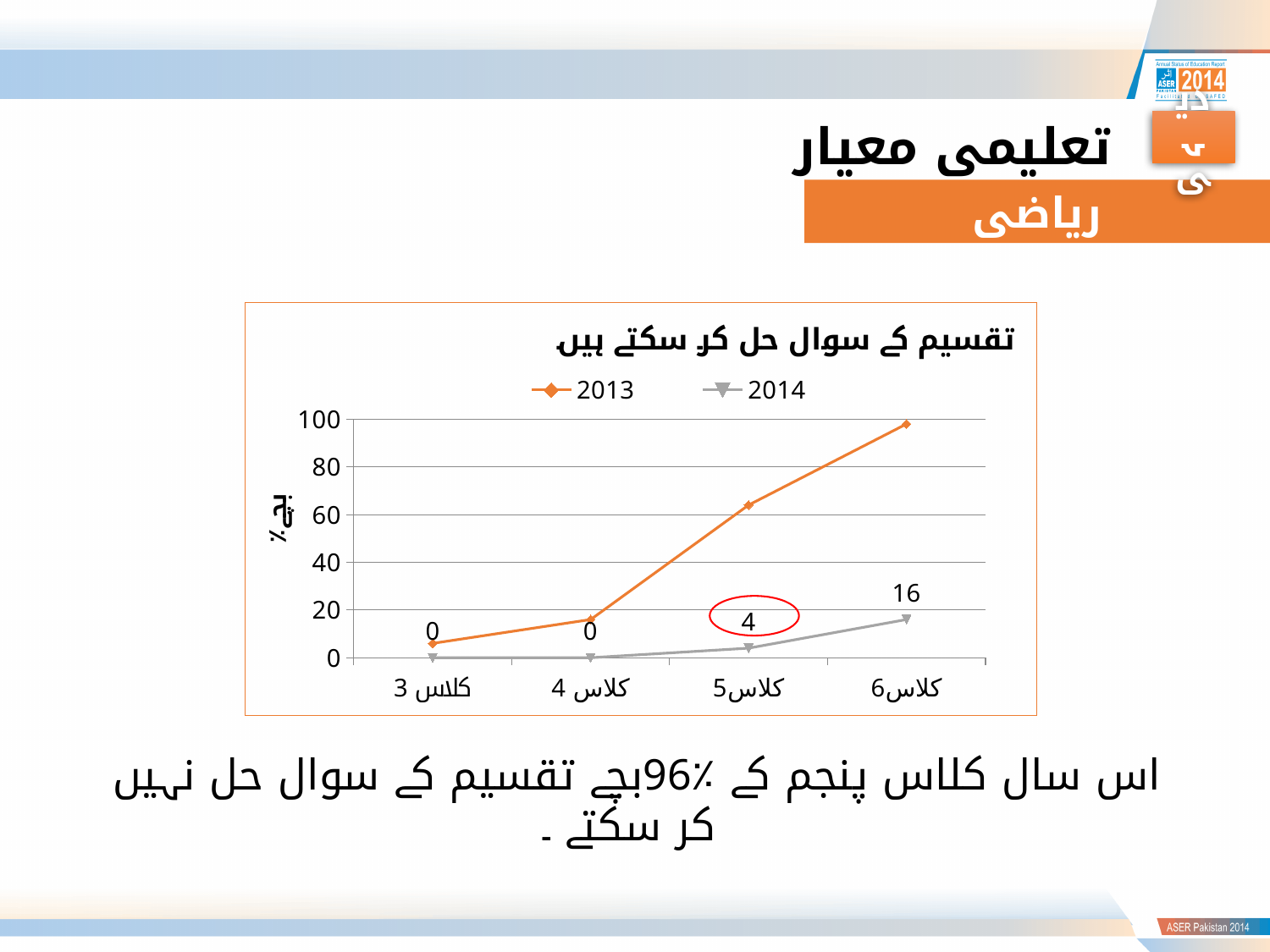
Which category has the highest 2014 value? کلاس 6 What is the 2014 value for کلاس 3? 0 What kind of chart is shown on the slide? line chart Is the 2013 value for کلاس 3 greater or less than 20? less What is the 2014 value for کلاس 5? 4 How many series does the legend list? 2 At کلاس 6, which series has the larger value, 2013 or 2014? 2013 What is the 2014 value for کلاس 6? 16 Do the 2013 values rise or fall from کلاس 3 to کلاس 6? rise Is the 2013 value for کلاس 6 greater or less than 80? greater What is the difference between the 2014 values for کلاس 6 and کلاس 5? 12 How many categories are shown on the x axis? 4